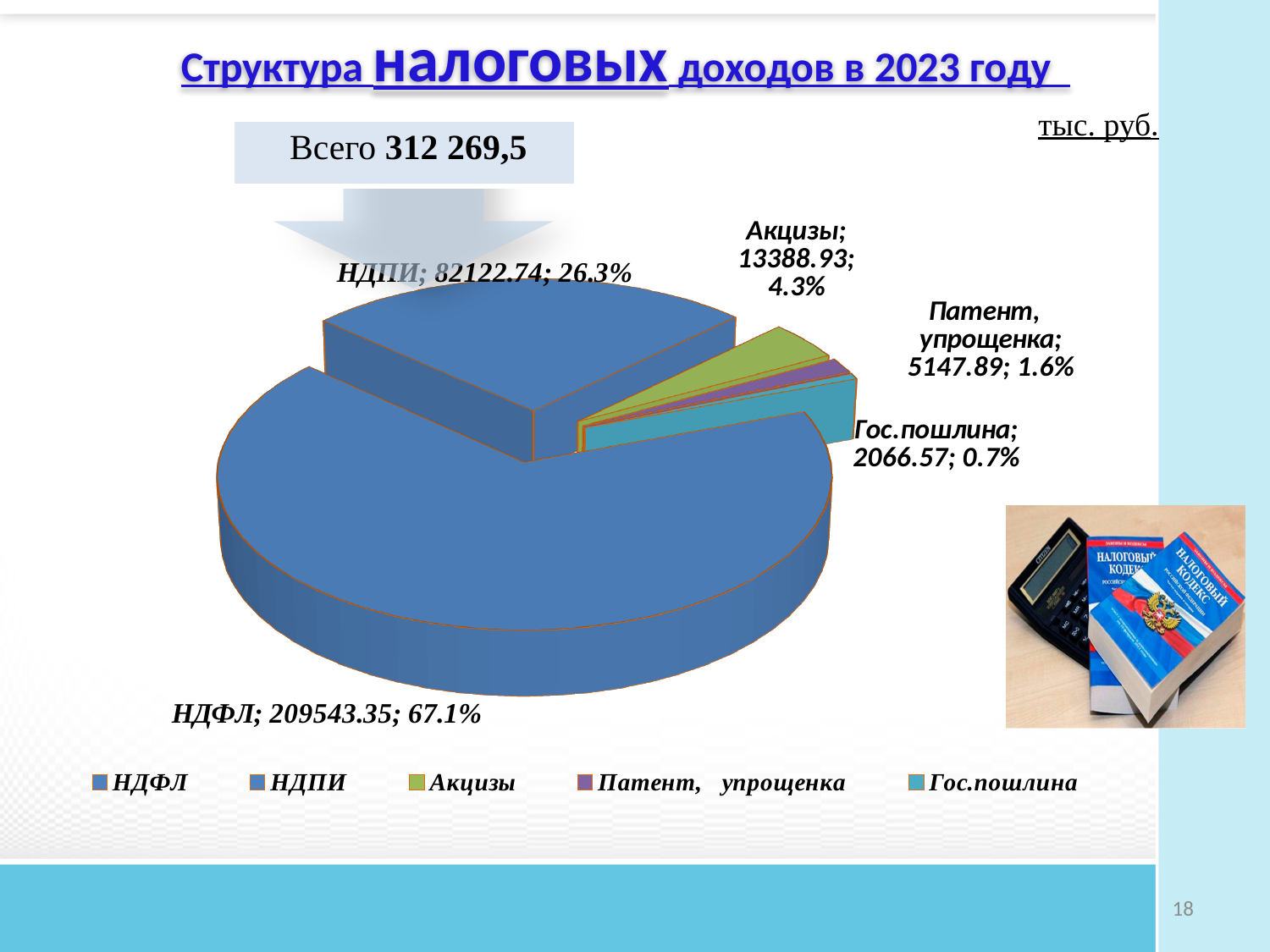
What share of the pie does НДФЛ take? 67.1% Which is larger, Акцизы or Патент, упрощенка? Акцизы What kind of chart is shown on the slide? pie chart What is the value for Гос.пошлина? 2066.57 What is the value for Акцизы? 13388.93 What share of the pie does Патент, упрощенка take? 1.6% What is the value for НДФЛ? 209543.35 Which category has the smallest slice? Гос.пошлина What is the difference between the values for НДФЛ and НДПИ? 127420.61 Which category has the largest slice? НДФЛ What is the value for НДПИ? 82122.74 How many categories does the legend list? 5